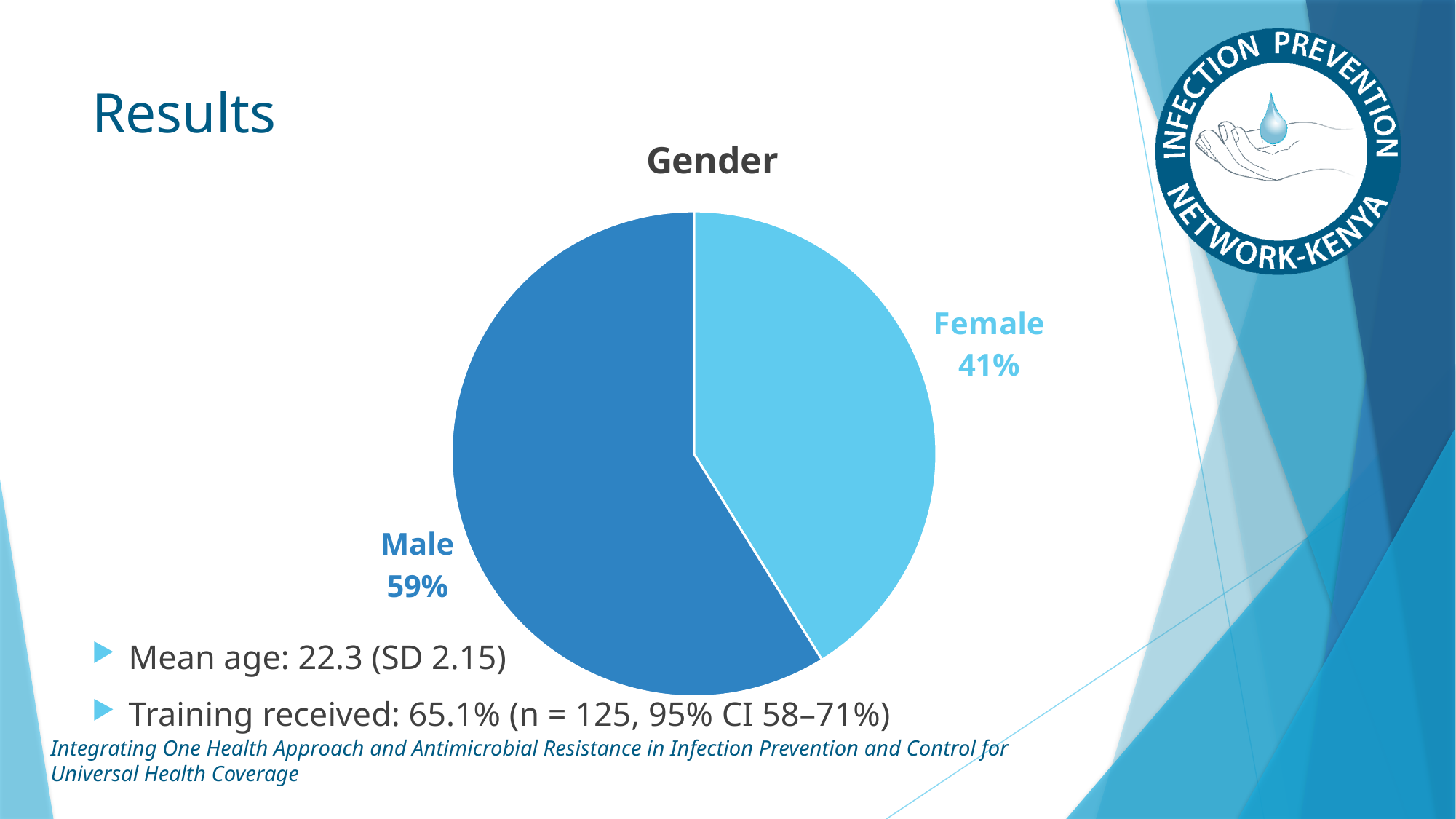
Which is larger in the pie chart, Male or Female? Male What percentage of the pie chart is Female? 41% Which slice of the pie chart is the smallest? Female What percentage of the pie chart is Male? 59% What is the difference in percentage points between the Male and Female slices? 18 What is the title of the chart? Gender How many slices does the pie chart have? 2 What type of chart is shown on the slide? pie chart Which slice of the pie chart is the largest? Male What share of the pie does the Female slice represent? 41% Which slice of the pie chart is shown in the darker blue colour? Male